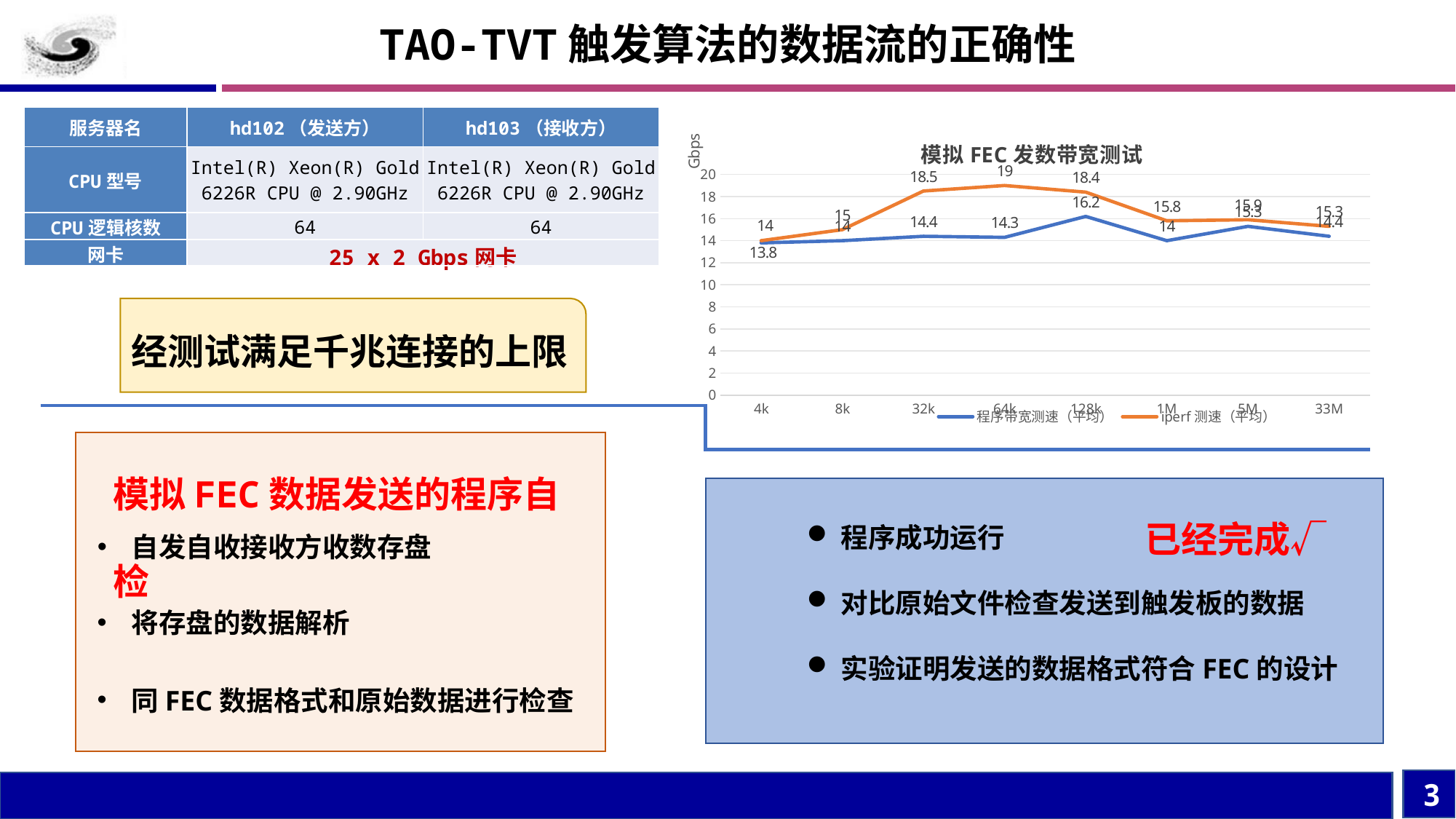
Is the iperf 测速（平均） value at 64k greater or less than 18? greater Which series has the larger value at 128k, iperf 测速（平均） or 程序带宽测速（平均）? iperf 测速（平均） What type of chart is shown on the slide? line chart How many series does the chart legend list? 2 What is the 程序带宽测速（平均） value at 128k? 16.2 What is the difference between iperf 测速（平均） and 程序带宽测速（平均） at 32k? 4.1 How many categories are on the x axis of the chart? 8 What is the iperf 测速（平均） value at 64k? 19 What is the title of the chart? 模拟 FEC 发数带宽测试 At which x-axis category is the 程序带宽测速（平均） value lowest? 4k At which x-axis category does iperf 测速（平均） reach its highest value? 64k What is the 程序带宽测速（平均） value at 4k? 13.8